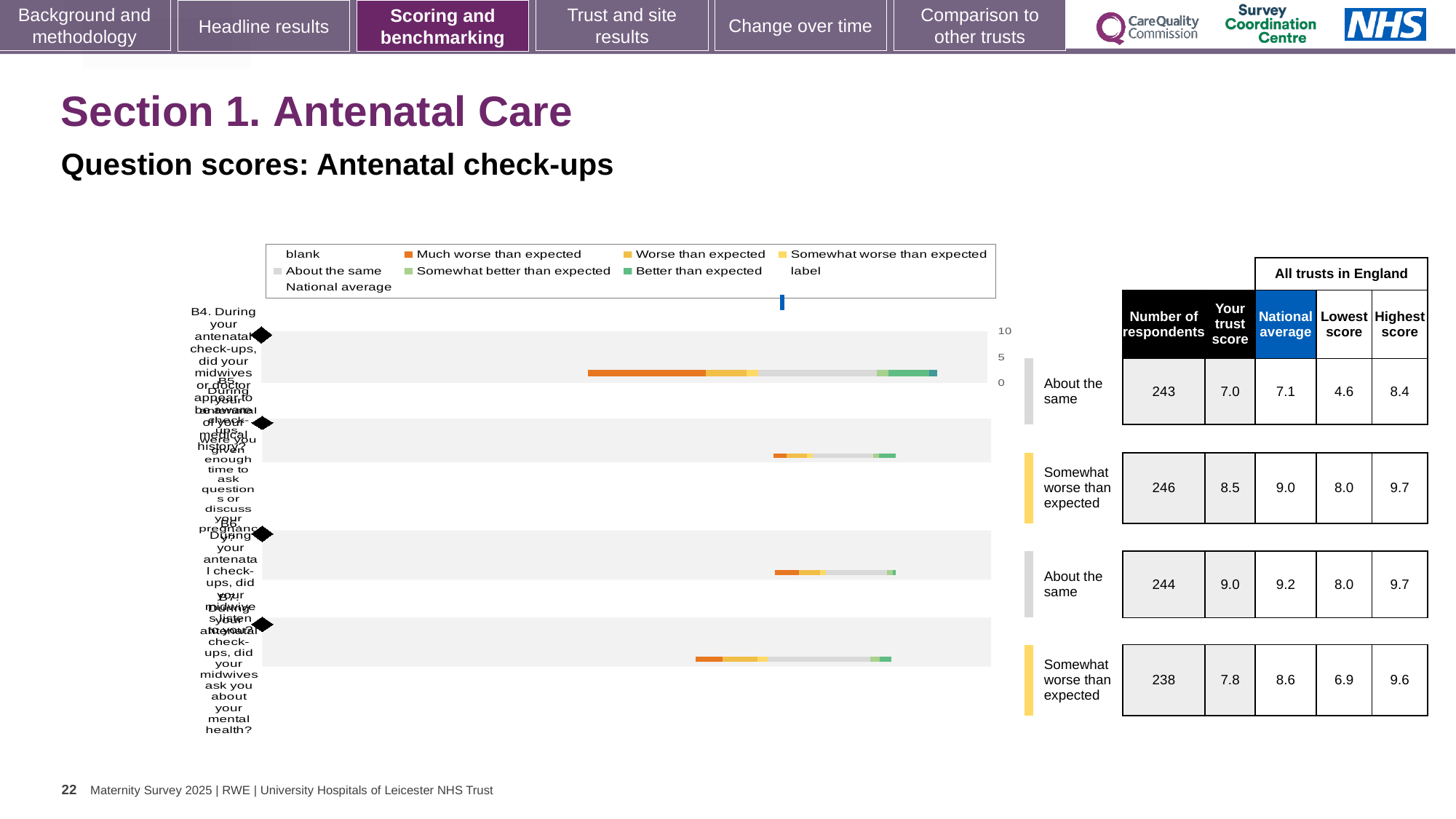
In the table beside the chart, what is the trust score for the first row (B4)? 7.0 In the table beside the chart, which row has the highest number of respondents? the second row (246) What is the highest tick value shown on the chart's axis? 10 How many horizontal bars (question rows) are plotted in the chart? 4 Which colour does the legend use for 'Much worse than expected'? orange In the table beside the chart, what is the lowest score across all trusts in England for the first row (B4)? 4.6 In the table beside the chart, is the trust score or the national average larger for the last row (B7)? national average What kind of chart is shown on the slide? bar chart In the table beside the chart, what is the national average for the last row (B7, asked about mental health)? 8.6 In the table beside the chart, what is the number of respondents for the first row (B4, awareness of medical history)? 243 In the table beside the chart, what is the highest score across all trusts in England for the last row (B7)? 9.6 In the table beside the chart, what is the difference between the national average and the trust score for the first row (B4)? 0.1